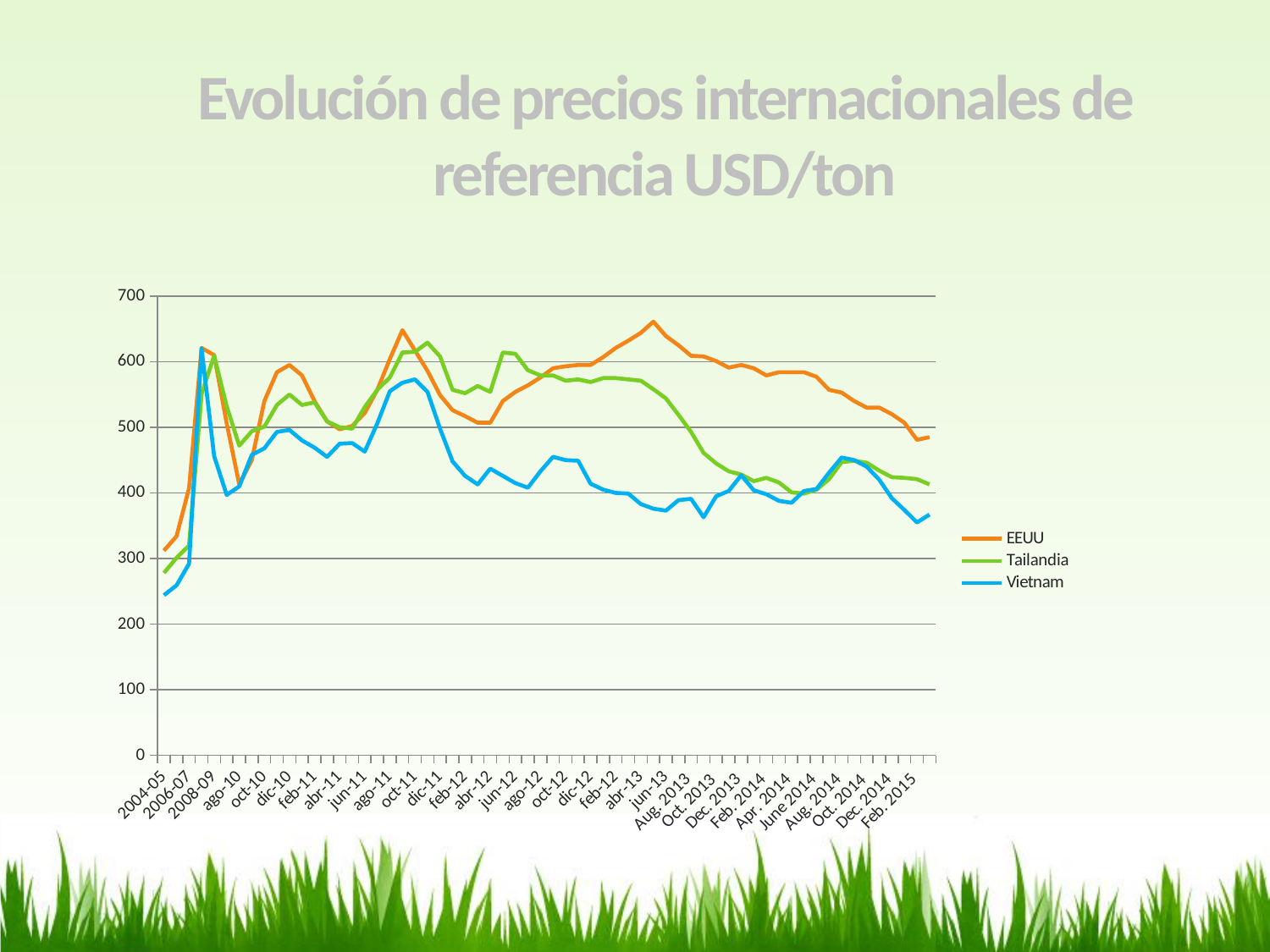
Is the value for Vietnam at 2004-05 greater or less than 300? less Is the value for Tailandia at Feb. 2015 greater or less than 500? less Does the EEUU series rise or fall from jun-13 to Feb. 2015? fall Is the value for Vietnam at Feb. 2015 greater or less than 400? less At jun-13, which series has the higher value, EEUU or Vietnam? EEUU What is the title of the chart? Evolución de precios internacionales de referencia USD/ton Which series has the lowest value at Feb. 2015? Vietnam What kind of chart is shown on the slide? line chart Which colour is used for the Vietnam series? blue How many series does the legend list? 3